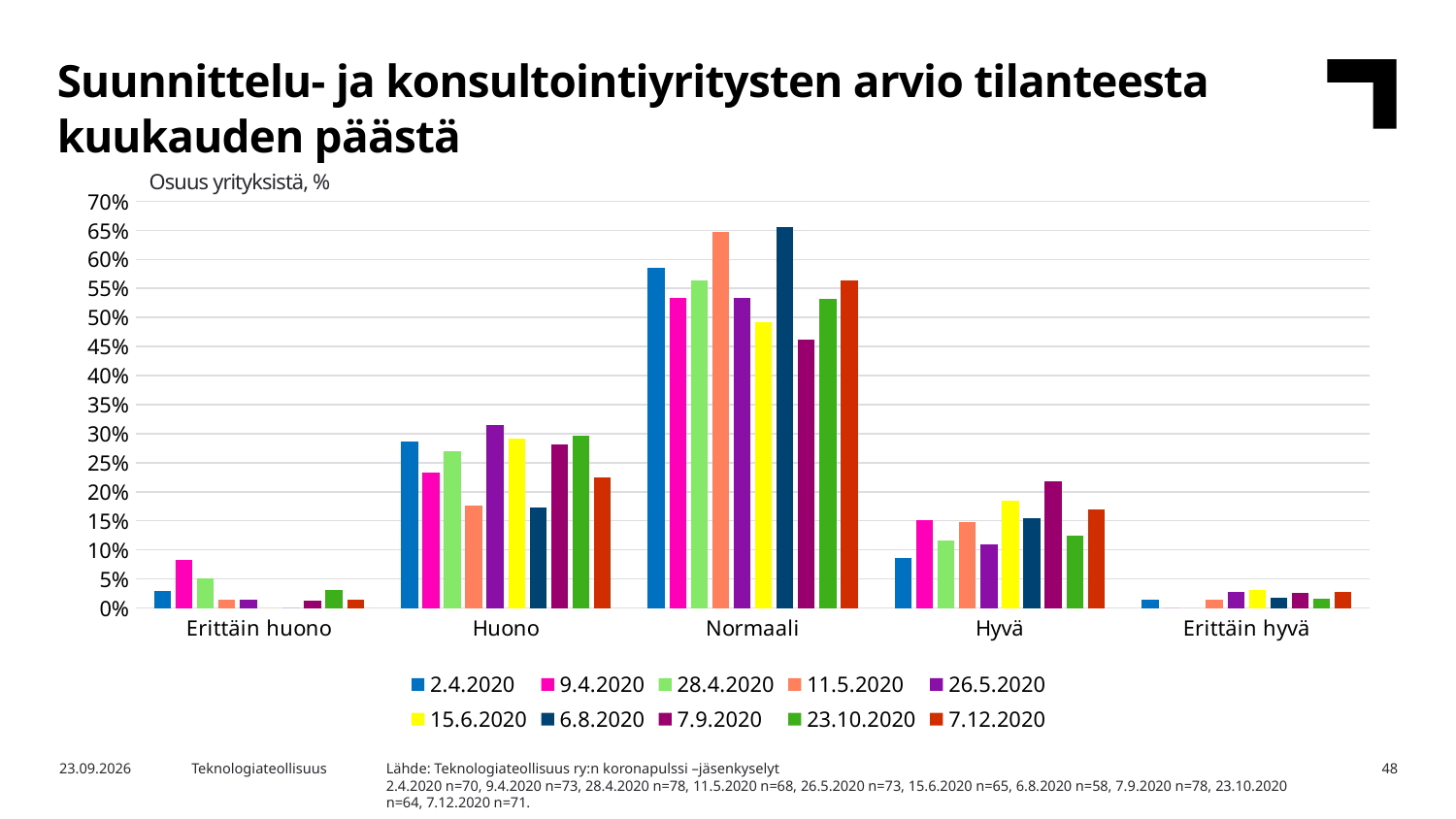
Is the value for 7.9.2020 in the Normaali category greater or less than 50%? less What is the label shown above the y axis of the chart? Osuus yrityksistä, % Is the value for 15.6.2020 in the Hyvä category greater or less than 15%? greater In the Huono category, which is larger: the value for 26.5.2020 or for 11.5.2020? 26.5.2020 In the Hyvä category, which is larger: the value for 7.9.2020 or for 2.4.2020? 7.9.2020 What kind of chart is shown on the slide? bar chart For the 7.12.2020 series, which category has the highest value? Normaali Is the value for 11.5.2020 in the Huono category greater or less than 20%? less In the Hyvä category, which series has the highest value? 7.9.2020 How many categories are shown on the x axis of the chart? 5 How many series does the legend list? 10